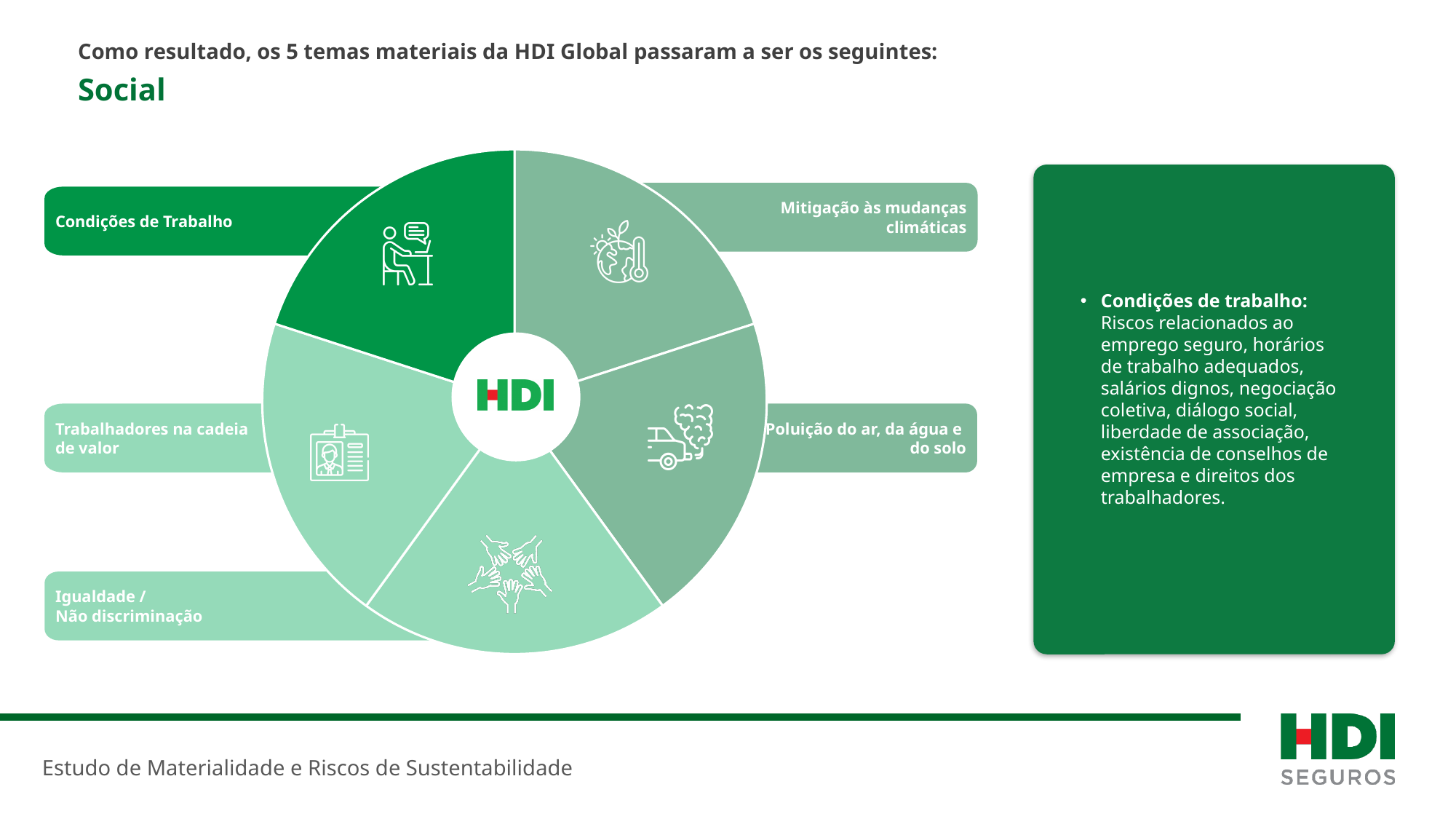
Which label is attached to the left-hand segment of the circular diagram? Trabalhadores na cadeia de valor What kind of chart is the circular diagram in the centre of the slide? Pie chart What logo appears in the centre of the circular diagram? HDI Which label is attached to the right-hand segment of the circular diagram? Poluição do ar, da água e do solo How many segments does the circular diagram in the centre of the slide have? 5 Which label is attached to the bottom-left segment of the circular diagram? Igualdade / Não discriminação Which segment of the circular diagram is highlighted in dark green? Condições de Trabalho Which label is attached to the top-right segment of the circular diagram? Mitigação às mudanças climáticas